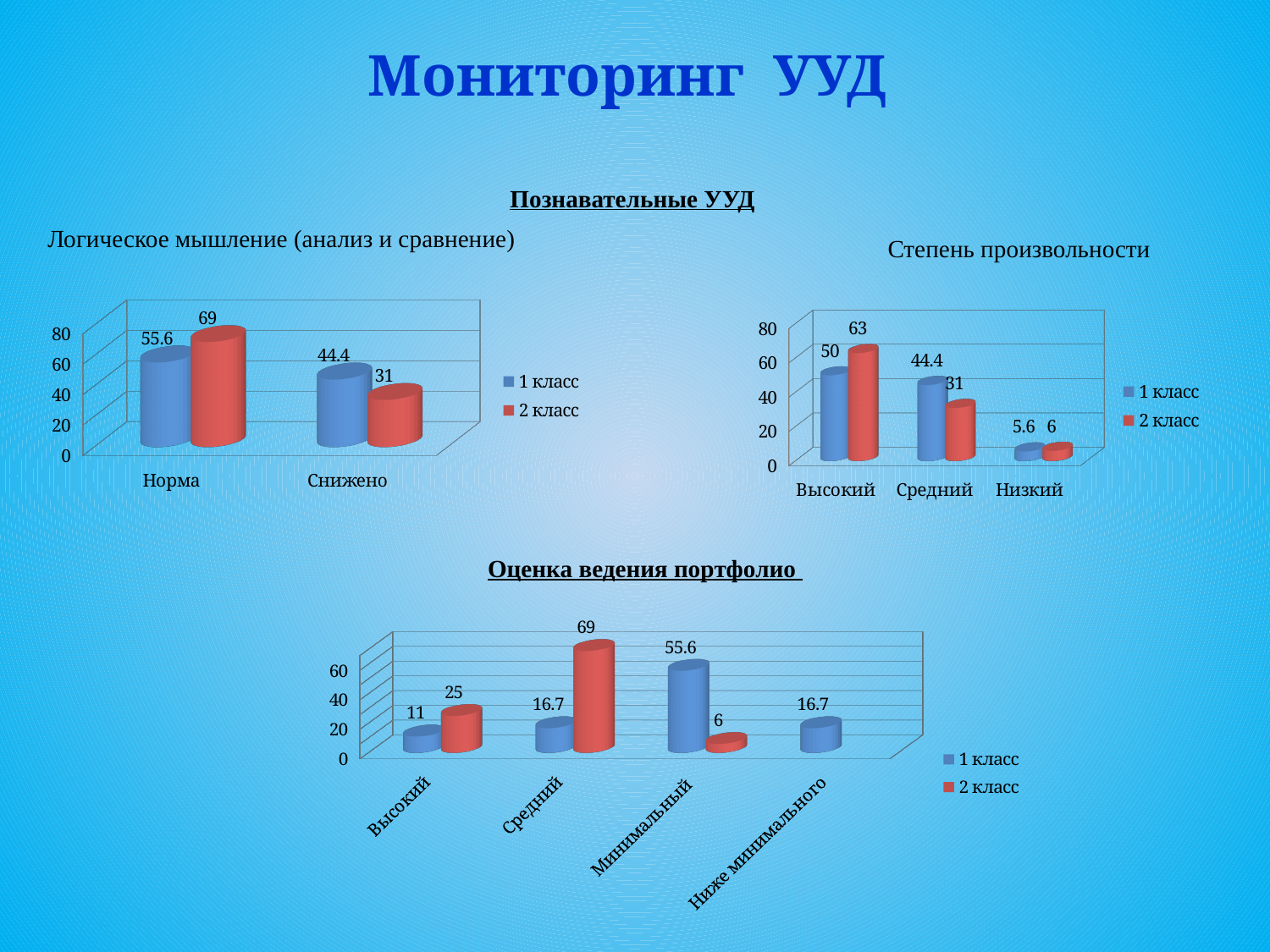
In the 'Оценка ведения портфолио' chart, what is the value for 'Средний' for '2 класс'? 69 How many series does the legend of the 'Оценка ведения портфолио' chart list? 2 What type of chart is the 'Степень произвольности' chart? Bar chart In the 'Степень произвольности' chart, which category has the lowest value for '1 класс'? Низкий In the 'Степень произвольности' chart, what is the value for 'Высокий' for '2 класс'? 63 In the 'Логическое мышление (анализ и сравнение)' chart, what is the difference between the '2 класс' and '1 класс' values for 'Норма'? 13.4 In the 'Логическое мышление (анализ и сравнение)' chart, what is the value for 'Норма' for '2 класс'? 69 In the 'Оценка ведения портфолио' chart, which category has the highest value for '1 класс'? Минимальный In the 'Степень произвольности' chart, which is larger for 'Средний': '1 класс' or '2 класс'? 1 класс In the 'Степень произвольности' chart, how many categories are shown on the x axis? 3 In the 'Оценка ведения портфолио' chart, what is the difference between the '1 класс' and '2 класс' values for 'Минимальный'? 49.6 In the 'Логическое мышление (анализ и сравнение)' chart, what is the value for 'Снижено' for '1 класс'? 44.4